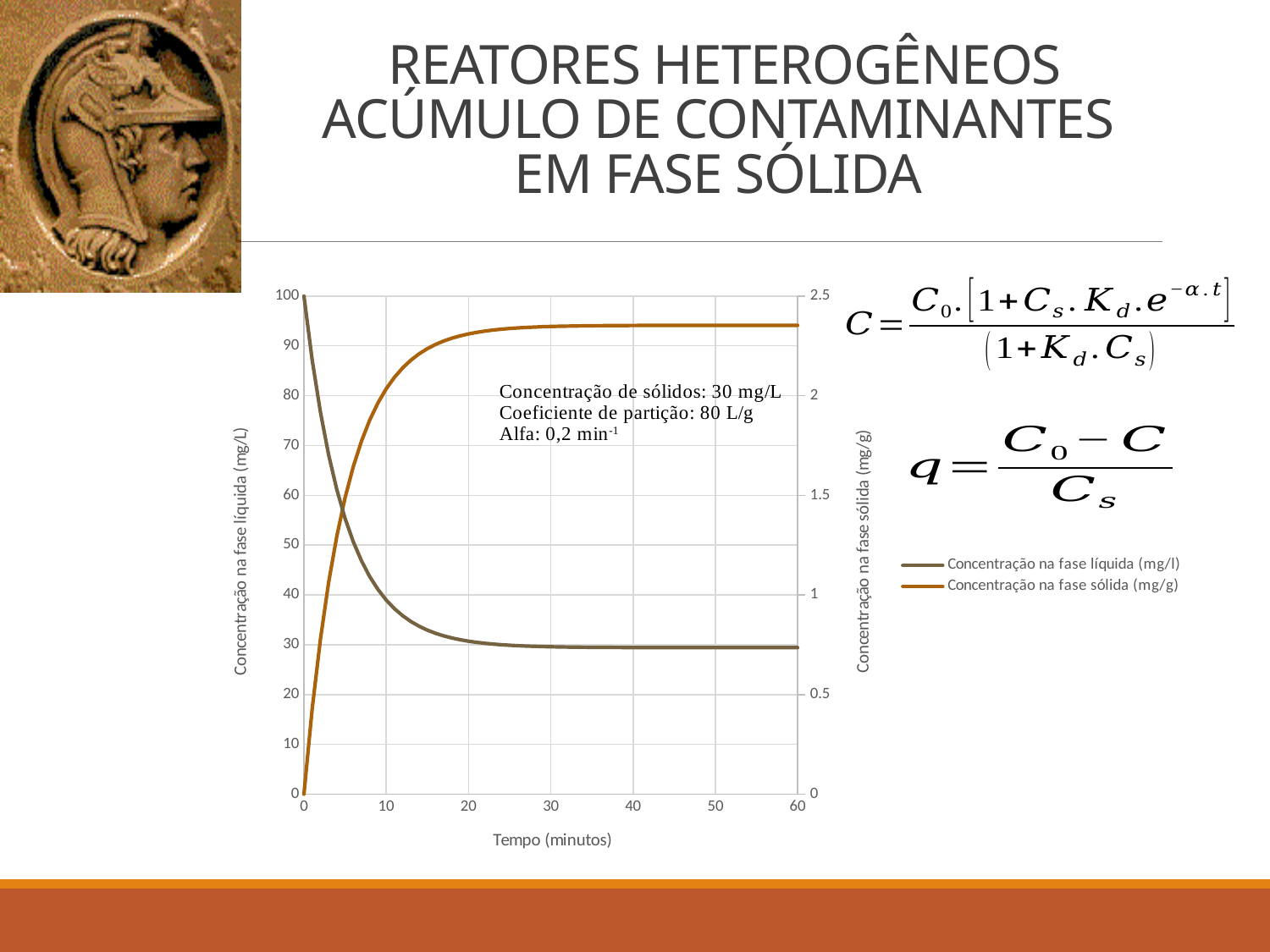
According to the annotation on the chart, what is the 'Concentração de sólidos'? 30 mg/L Is the value of 'Concentração na fase líquida (mg/l)' at 20 minutes greater or less than 40? less What is the value of 'Concentração na fase líquida (mg/l)' at time 0 minutes? 100 Is the value of 'Concentração na fase sólida (mg/g)' at 10 minutes greater or less than 1.5? greater What is the title of the x axis of the chart? Tempo (minutos) Is the value of 'Concentração na fase sólida (mg/g)' at 60 minutes greater or less than 2? greater Does the 'Concentração na fase líquida (mg/l)' series rise or fall as time increases? fall How many series does the chart legend list? 2 What is the value of 'Concentração na fase sólida (mg/g)' at time 0 minutes? 0 What kind of chart is shown on the slide? line chart Does the 'Concentração na fase sólida (mg/g)' series rise or fall as time increases? rise